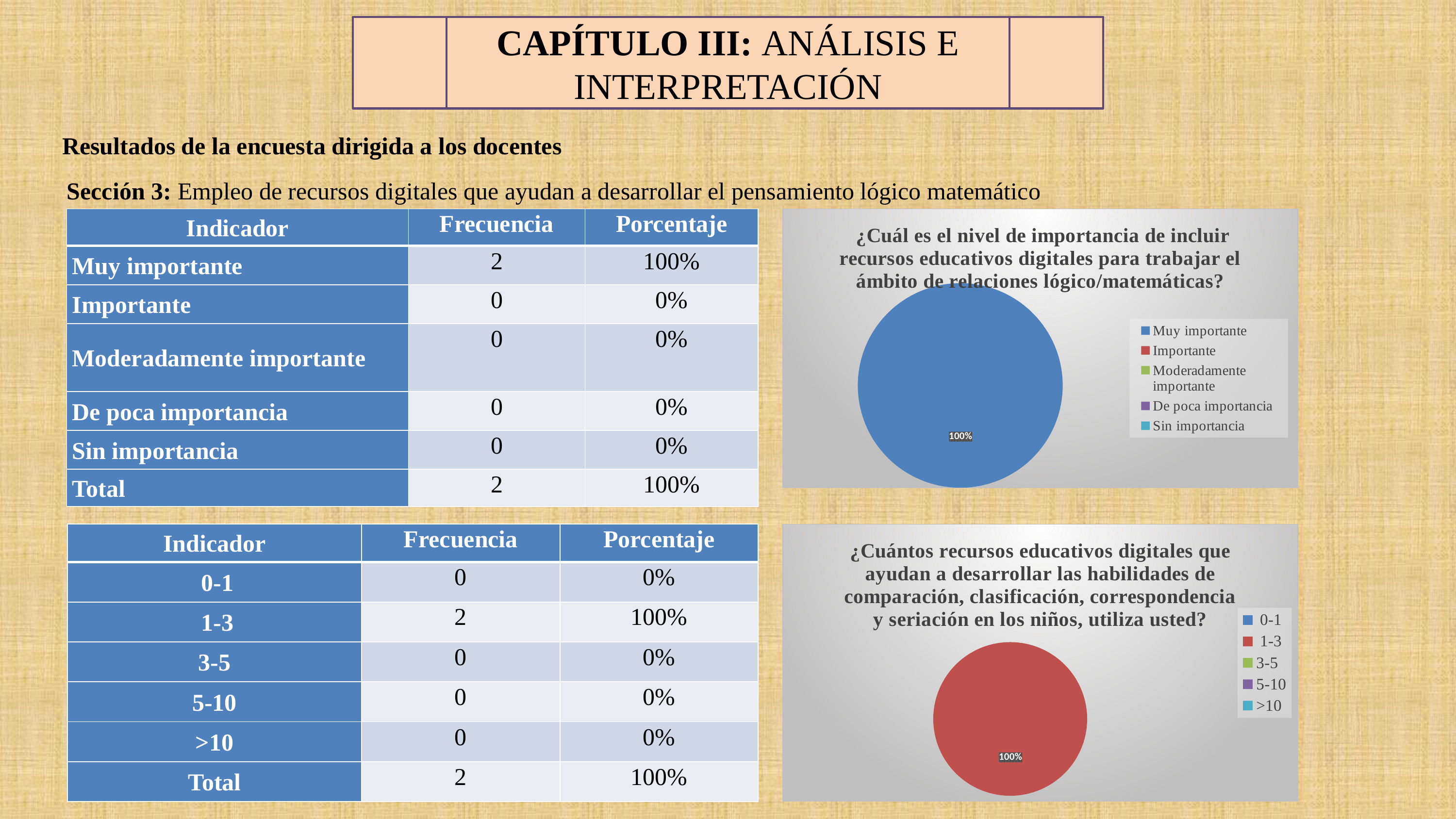
In the bottom-right pie chart, which category makes up the entire pie? 1-3 In the top-right pie chart, which category makes up the entire pie? Muy importante What kind of chart is the bottom-right chart titled "¿Cuántos recursos educativos digitales...utiliza usted?"? pie chart What kind of chart is the top-right chart titled "¿Cuál es el nivel de importancia de incluir recursos educativos digitales...?"? pie chart In the top-right pie chart, is the share for "Muy importante" greater or less than 50%? greater In the top-right pie chart, what colour is the slice for "Muy importante"? blue How many entries does the legend of the top-right pie chart list? 5 In the bottom-right pie chart, which is larger, the share for "1-3" or the share for "0-1"? 1-3 In the bottom-right pie chart, what colour is the slice for "1-3"? red In the bottom-right pie chart, what share is shown on the data label of the single visible slice? 100% In the top-right pie chart, what share is shown on the data label of the single visible slice? 100% How many entries does the legend of the bottom-right pie chart list? 5